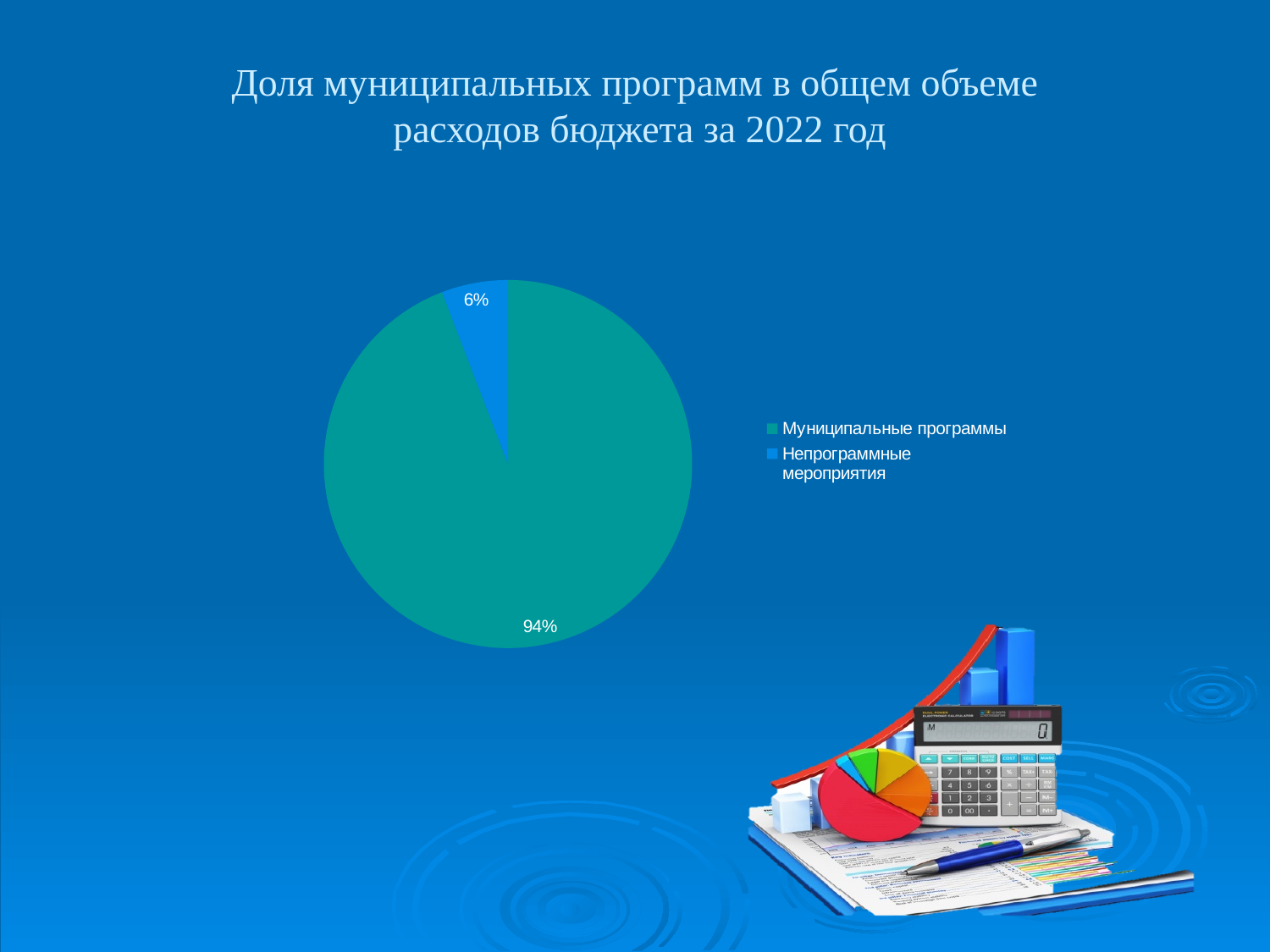
How many categories does the pie chart have? 2 Which category has the largest slice of the pie? Муниципальные программы Which is larger: the slice for Муниципальные программы or the slice for Непрограммные мероприятия? Муниципальные программы What is the title of the slide? Доля муниципальных программ в общем объеме расходов бюджета за 2022 год What share of the pie does Муниципальные программы have? 94% How many entries does the legend list? 2 Which category has the smallest slice of the pie? Непрограммные мероприятия What colour is the slice for Непрограммные мероприятия? blue What kind of chart is shown on the slide? pie chart What share of the pie does Непрограммные мероприятия have? 6% What is the difference in percentage points between Муниципальные программы and Непрограммные мероприятия? 88